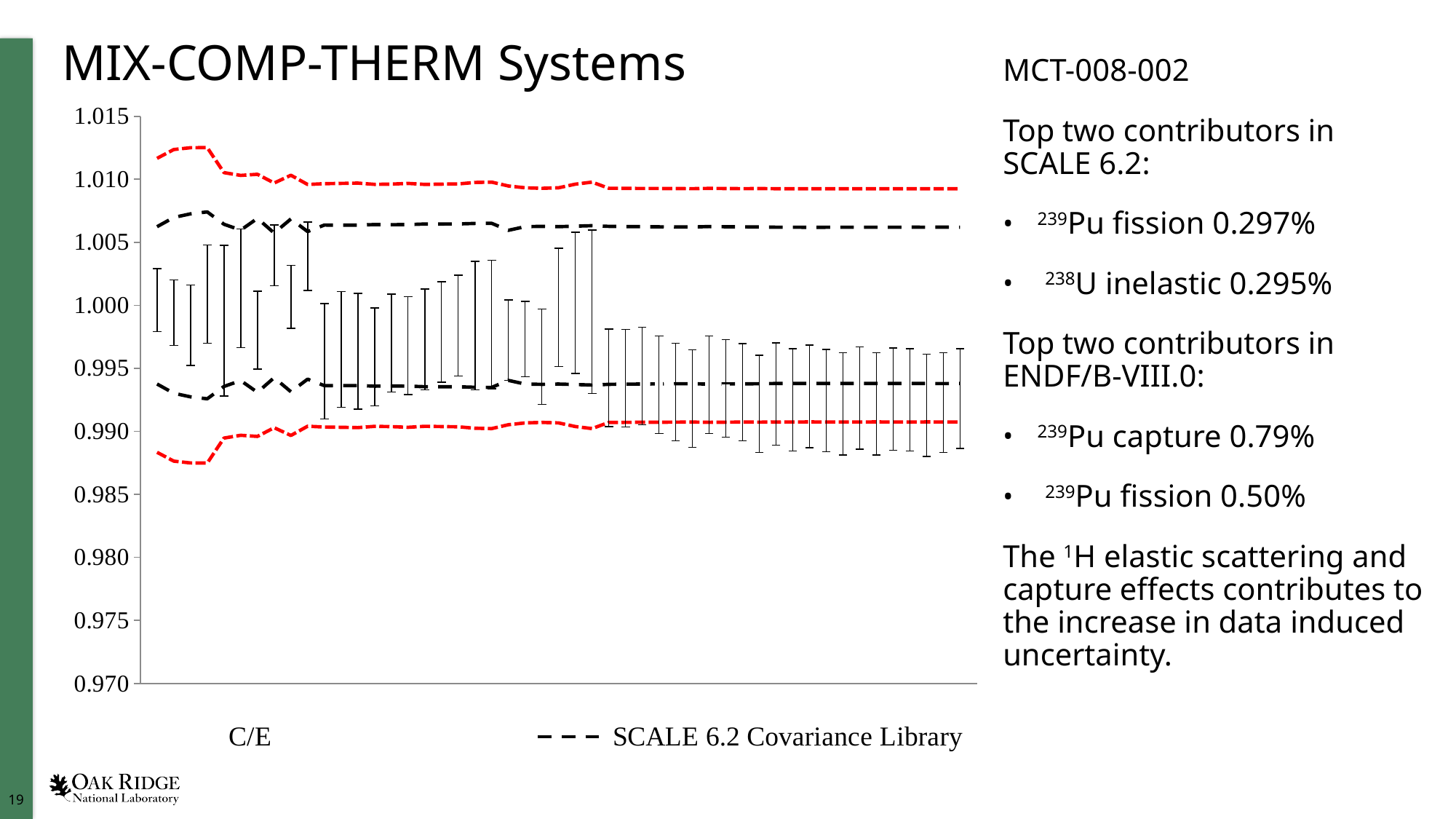
What are the two entries in the chart legend? C/E and SCALE 6.2 Covariance Library Is the upper red dashed line at the far left of the chart greater or less than 1.010? greater Is the lower red dashed line at the far left of the chart greater or less than 0.990? less How many series does the chart legend list? 2 What is the lowest value shown on the chart's y axis? 0.970 What is the highest value shown on the chart's y axis? 1.015 At the right side of the chart, which is higher: the upper red dashed line or the upper black dashed line? the upper red dashed line Is the lower black dashed line at the far right of the chart greater or less than 0.995? less What line style and colour represent the SCALE 6.2 Covariance Library in the chart? black dashed line What kind of chart is shown on the slide? line chart with error bars Do the C/E error bars get longer or shorter moving from left to right along the x axis? shorter